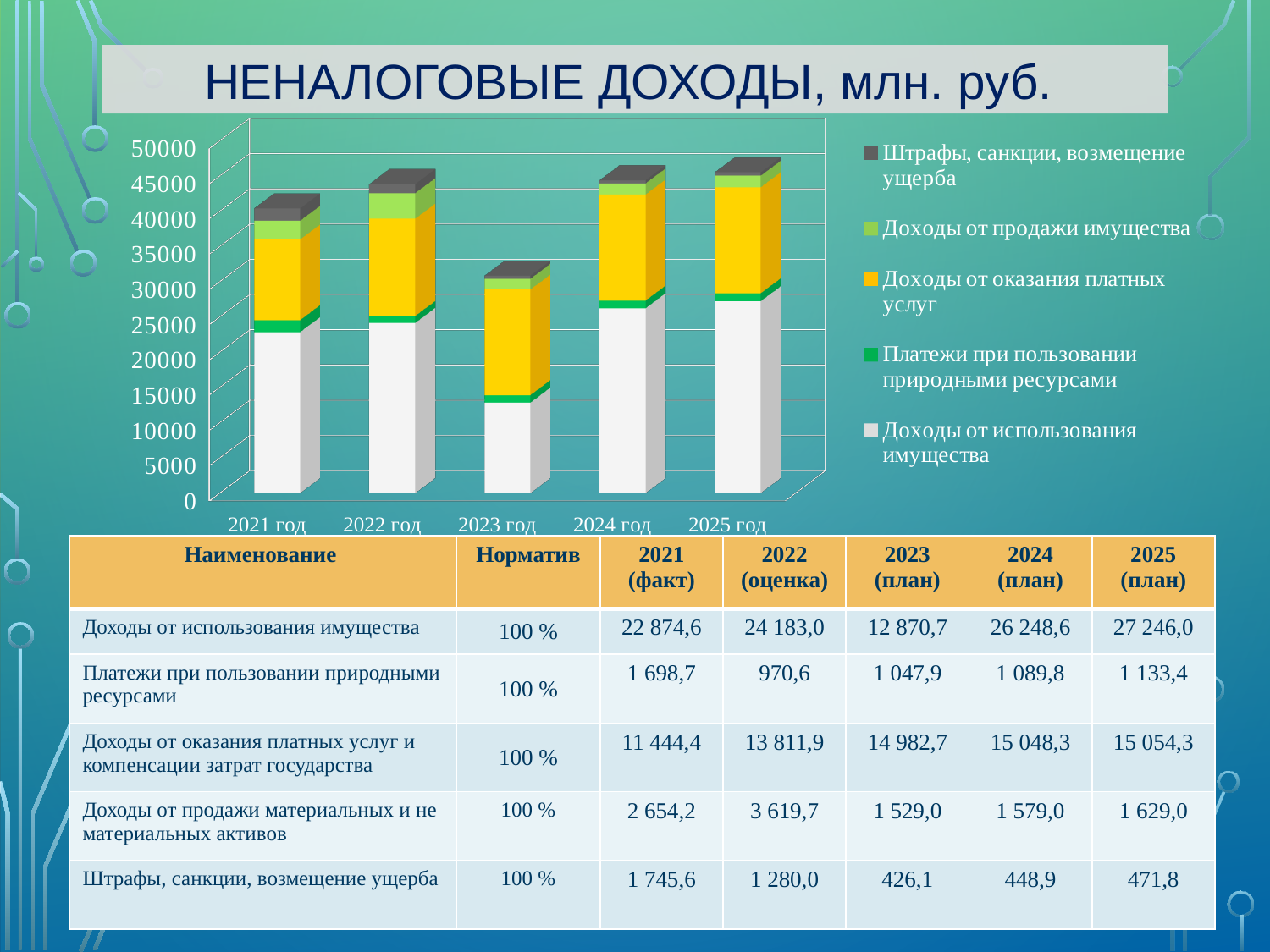
Is the total height of the 2025 год bar greater or less than 40000? greater Which year has the lowest total bar in the chart? 2023 год Using the table values, what is the difference between 'Платежи при пользовании природными ресурсами' in 2021 and in 2022? 728,1 According to the table on the slide, what is the value of 'Штрафы, санкции, возмещение ущерба' for 2025 (план)? 471,8 How many series does the chart legend list? 5 How many years (categories) are shown on the x axis of the chart? 5 What kind of chart is shown on the slide? stacked bar chart Does the 'Доходы от использования имущества' segment rise or fall from 2023 год to 2025 год? rise What colour represents 'Доходы от оказания платных услуг' in the chart legend? yellow Is the total height of the 2023 год bar greater or less than 35000? less Which total bar is taller, 2021 год or 2023 год? 2021 год According to the table on the slide, what is the value of 'Доходы от использования имущества' for 2021 (факт)? 22 874,6